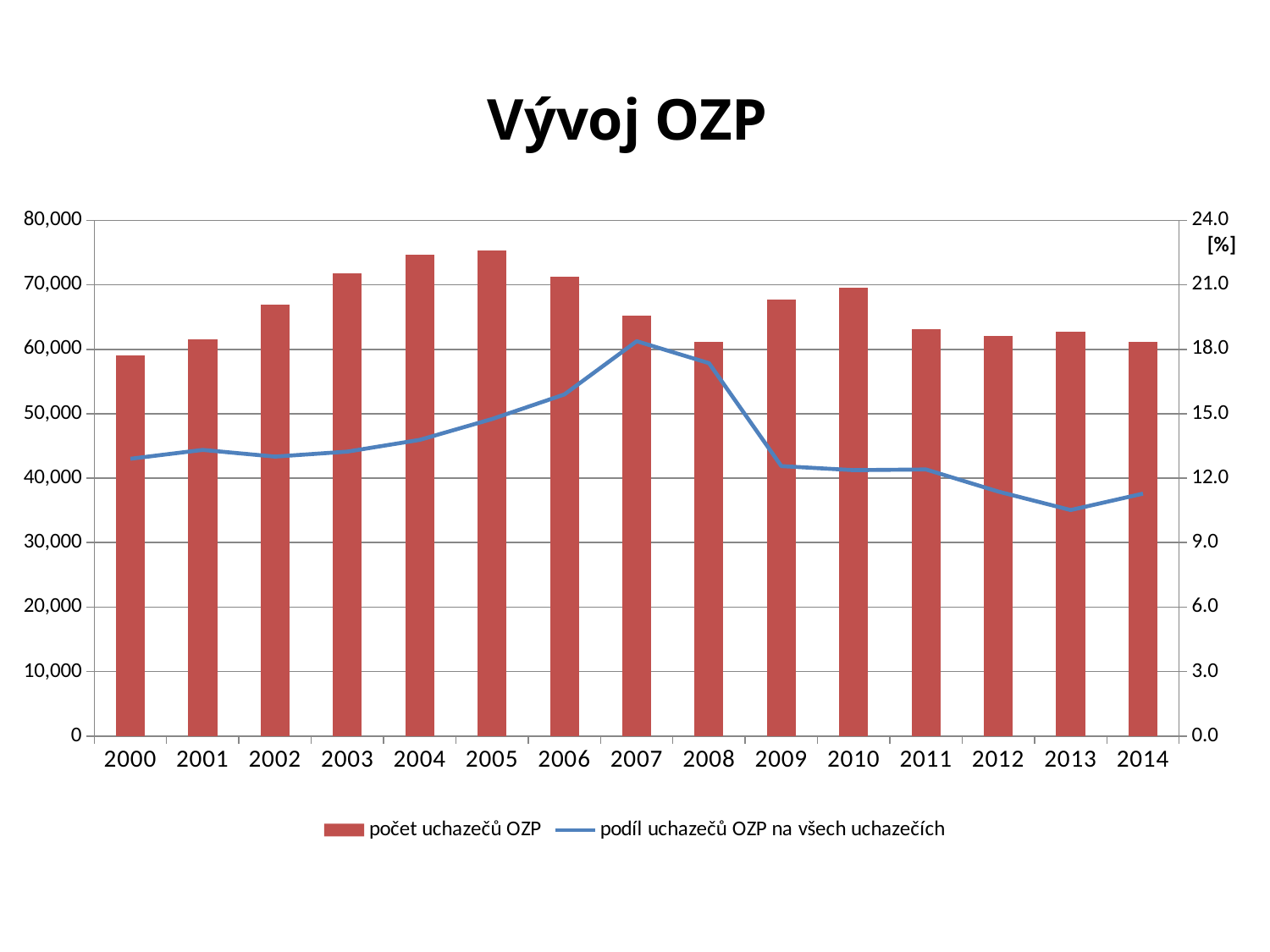
What kind of chart is shown on the slide? Combined bar and line chart How many years are shown on the x axis? 15 What is the title of the chart? Vývoj OZP Is the value of 'počet uchazečů OZP' for 2000 greater or less than 60,000? less Is the value of 'počet uchazečů OZP' for 2005 greater or less than 70,000? greater Does the line 'podíl uchazečů OZP na všech uchazečích' rise or fall from 2009 to 2013? fall In which year is the line 'podíl uchazečů OZP na všech uchazečích' at its highest? 2007 How many series does the legend list? 2 In which year is the bar 'počet uchazečů OZP' the lowest? 2000 Which year has the larger 'počet uchazečů OZP' bar, 2003 or 2008? 2003 In which year is the line 'podíl uchazečů OZP na všech uchazečích' at its lowest? 2013 Is the value of 'podíl uchazečů OZP na všech uchazečích' for 2013 greater or less than 12.0? less